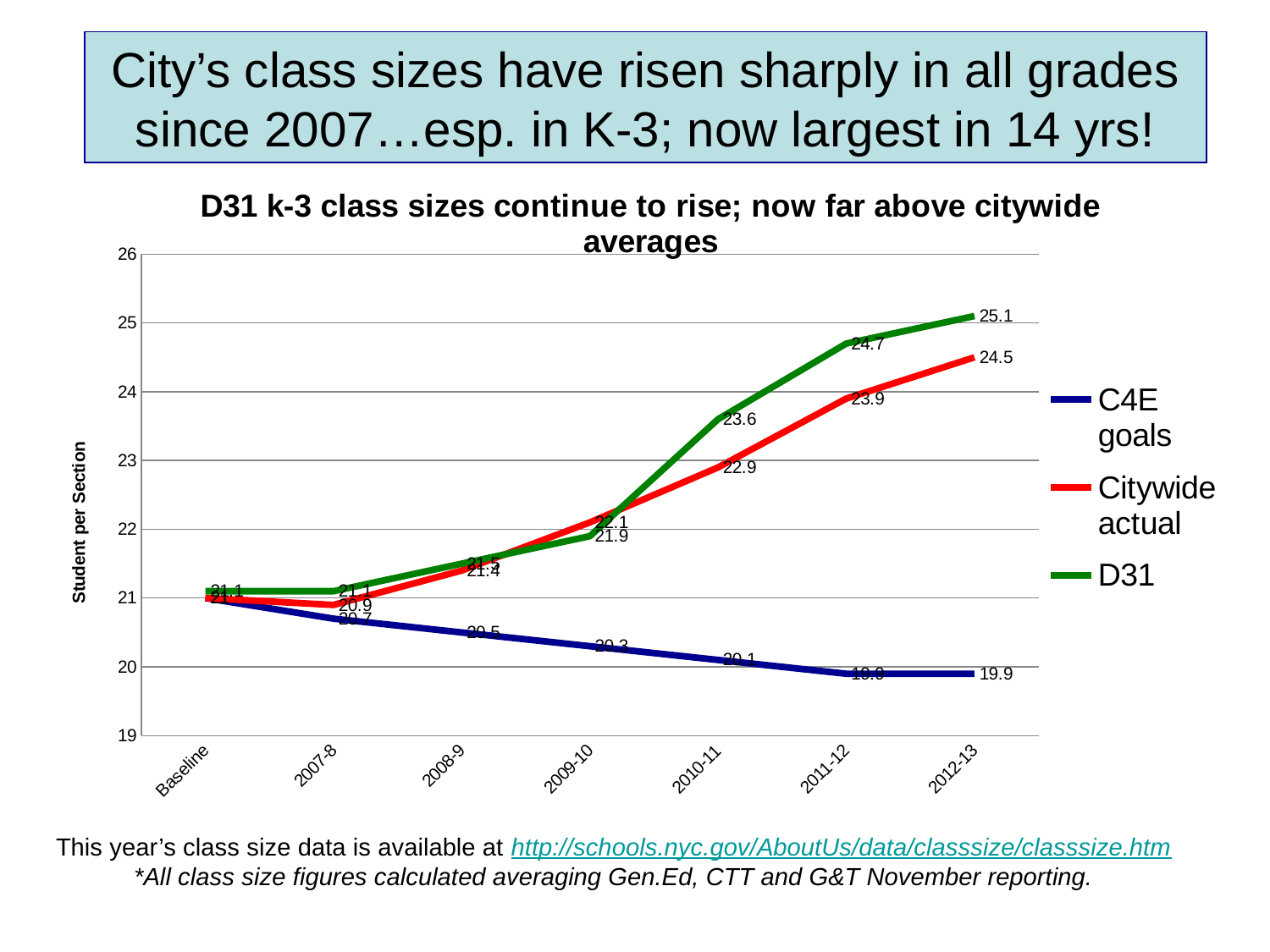
What is the difference between the D31 and Citywide actual values in 2012-13? 0.6 In 2010-11, which is larger: the D31 value or the Citywide actual value? D31 What is the D31 value for 2012-13? 25.1 What is the Citywide actual value for 2012-13? 24.5 What is the title of the y axis? Student per Section What is the Citywide actual value for 2011-12? 23.9 Do the C4E goals values rise or fall from Baseline to 2012-13? fall How many points are plotted along the x axis for each series? 7 How many series does the legend list? 3 What is the D31 value for 2010-11? 23.6 What is the C4E goals value for 2012-13? 19.9 What kind of chart is shown on the slide? line chart